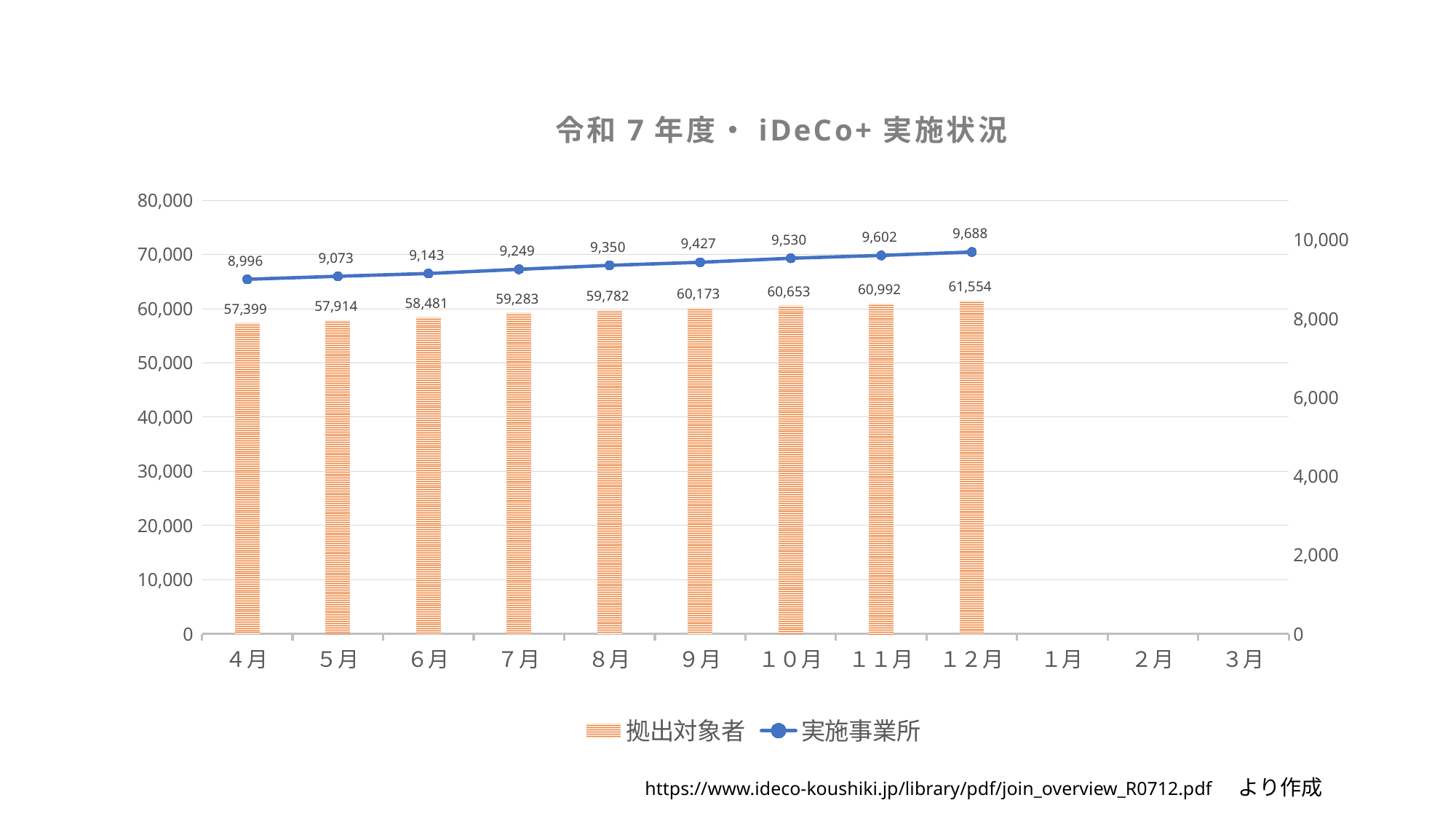
Do the 実施事業所 values rise or fall from 4月 to 12月? rise What is the value of 拠出対象者 for 4月? 57,399 Which month has the lowest value for 実施事業所? 4月 What is the difference between the 拠出対象者 values for 12月 and 4月? 4,155 What is the value of 実施事業所 for 12月? 9,688 What is the difference between the 実施事業所 values for 12月 and 4月? 692 Which month has the highest value for 拠出対象者? 12月 How many months have data plotted for 拠出対象者? 9 How many series does the legend list? 2 Which is larger, the 拠出対象者 value for 9月 or for 6月? 9月 What is the value of 拠出対象者 for 10月? 60,653 What is the value of 実施事業所 for 8月? 9,350